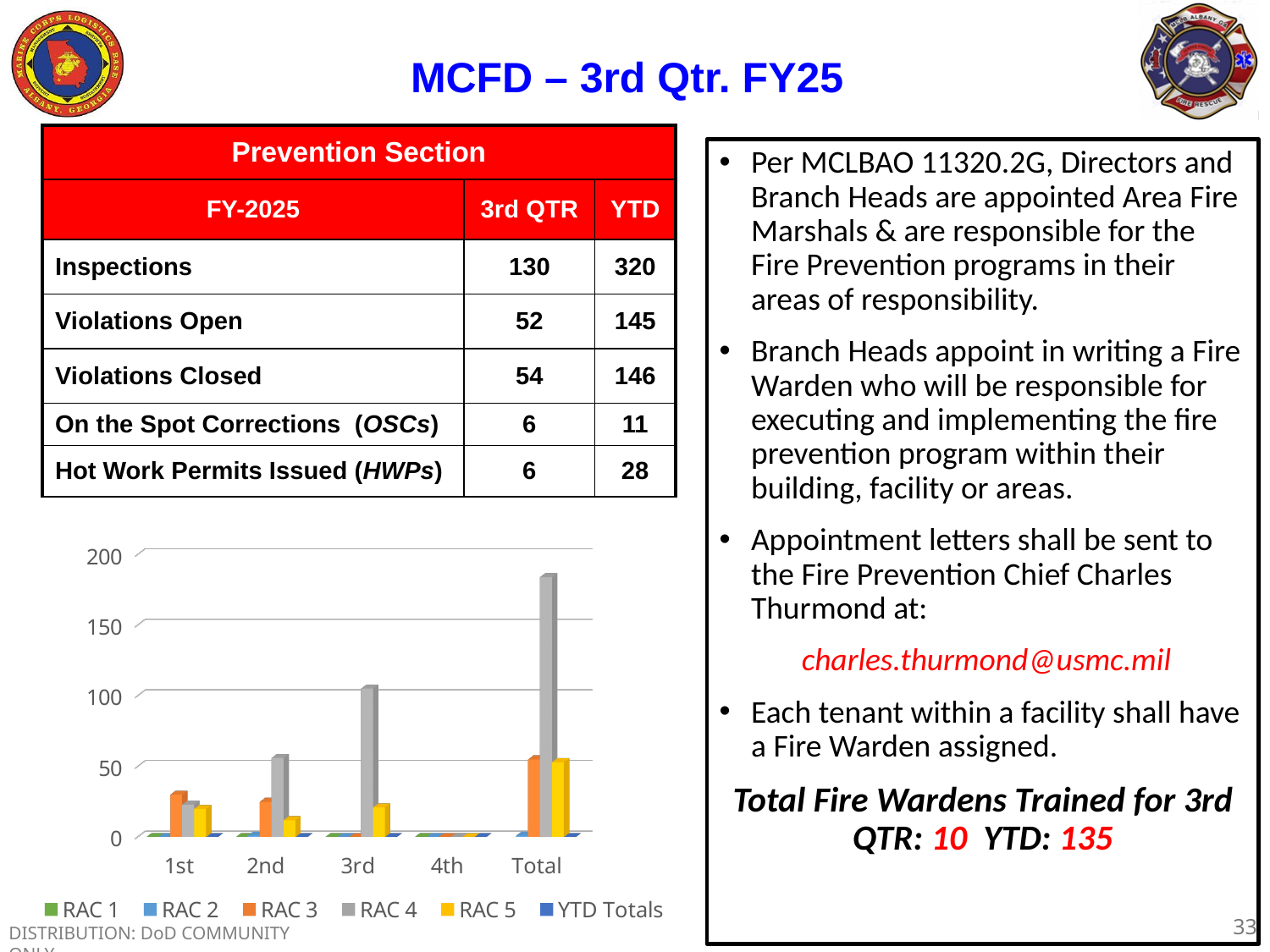
Do the RAC 4 values rise or fall from the 1st to the 3rd category? rise Is the value for RAC 3 in the 1st category greater or less than 50? less Is the value for RAC 4 in the 2nd category greater or less than 100? less In the 1st category, which is larger, RAC 3 or RAC 5? RAC 3 Is the value for RAC 4 in the Total category greater or less than 150? greater In the 2nd category, which is larger, RAC 3 or RAC 4? RAC 4 How many categories are shown along the x axis of the chart? 5 What is the highest value shown on the chart's vertical axis? 200 What kind of chart is shown on the slide? bar chart In which category is the RAC 4 bar the tallest? Total How many series does the chart's legend list? 6